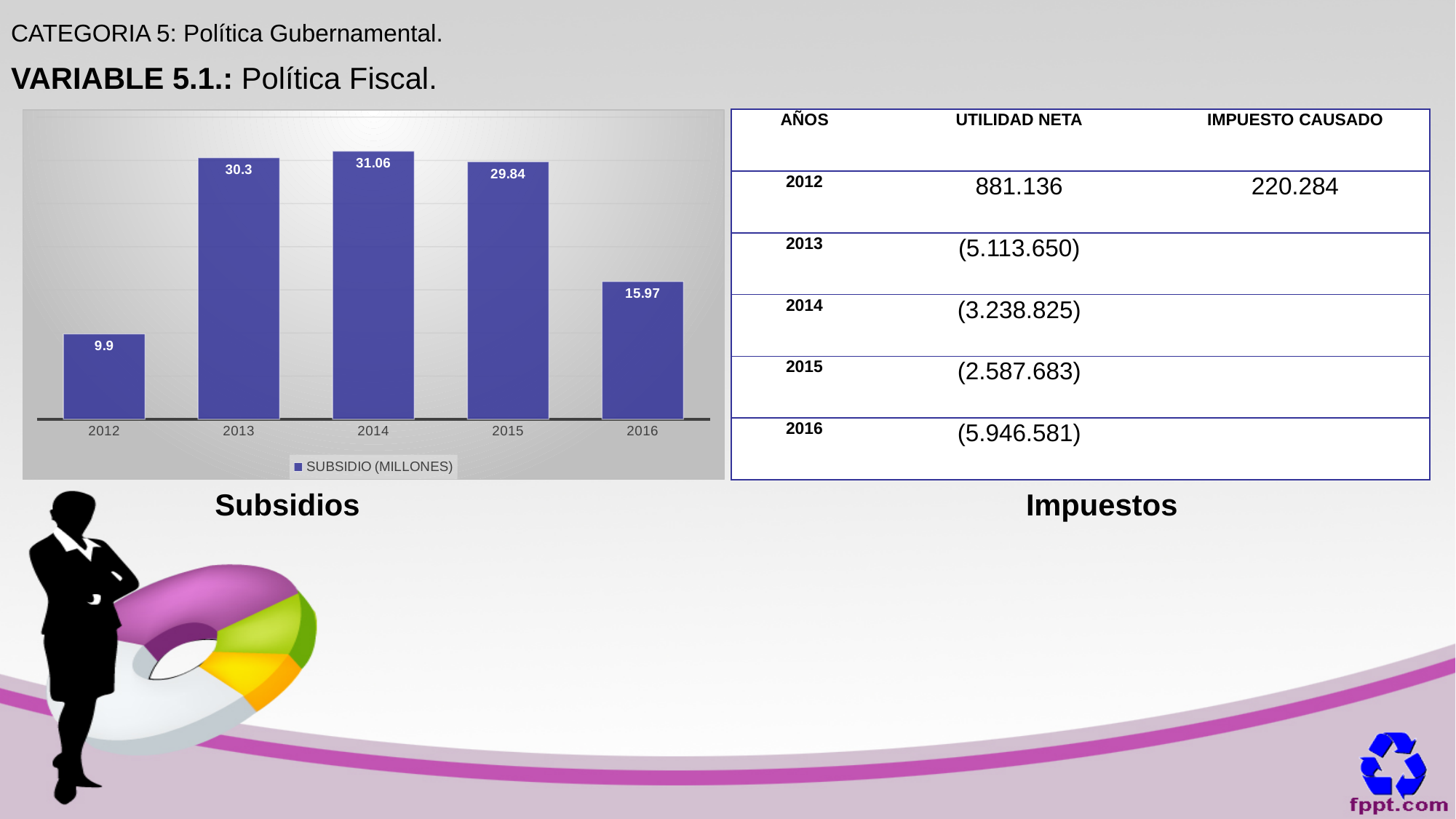
What is the difference between the subsidy values for 2014 and 2012? 21.16 What is the subsidy value shown for 2012 in the bar chart? 9.9 Which year has the lowest subsidy value in the bar chart? 2012 What is the subsidy value shown for 2014 in the bar chart? 31.06 Which year has the highest subsidy value in the bar chart? 2014 What is the difference between the subsidy values for 2015 and 2016? 13.87 How many series does the legend of the bar chart list? 1 How many years are shown on the x axis of the bar chart? 5 What is the series name shown in the legend of the bar chart? SUBSIDIO (MILLONES) What kind of chart is used to show the subsidies? Bar chart What is the subsidy value shown for 2016 in the bar chart? 15.97 Which year has a larger subsidy value, 2013 or 2016? 2013